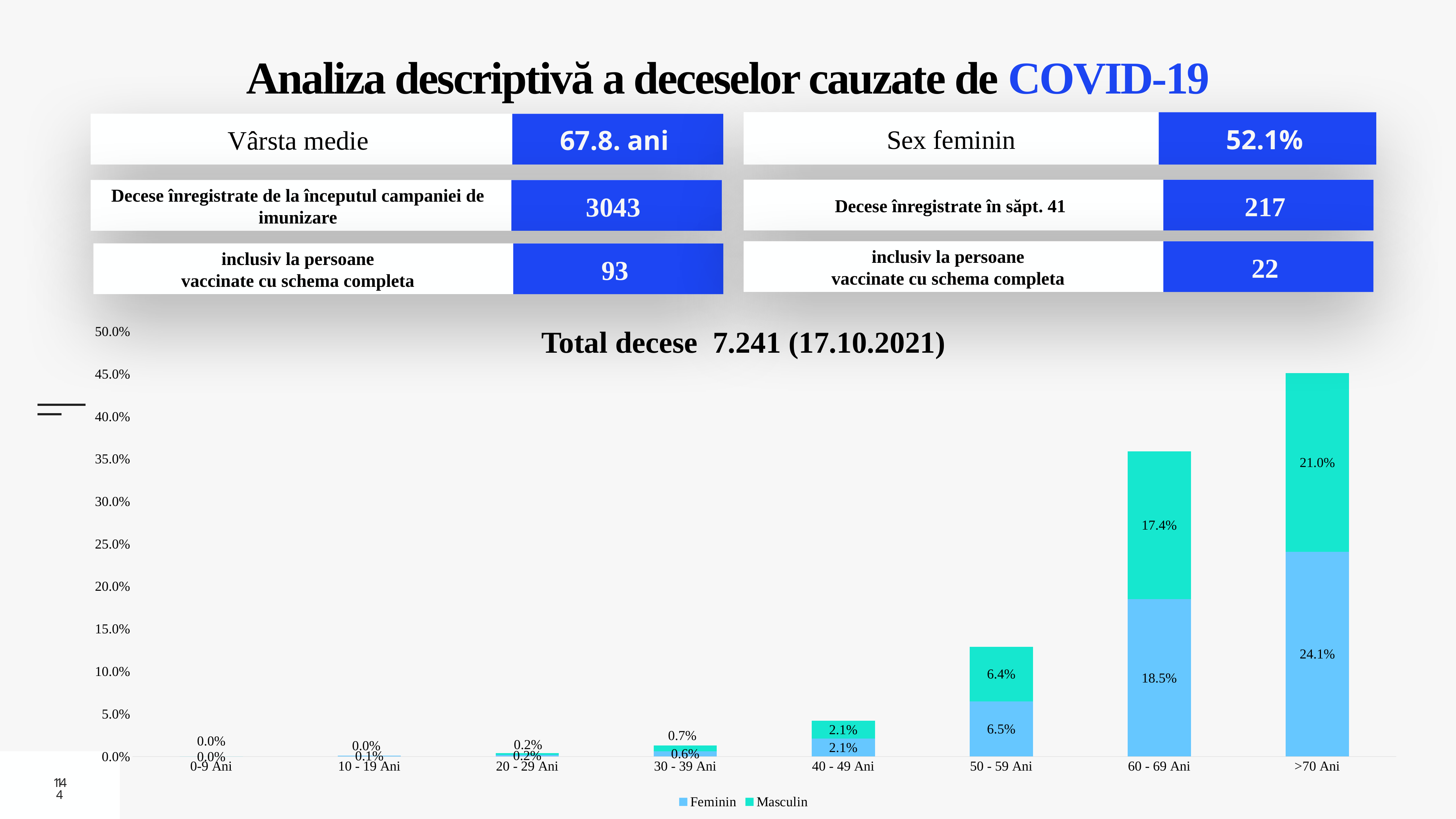
Which age group has the highest Masculin value? >70 Ani What is the Feminin value for the 50 - 59 Ani age group? 6.5% Is the total stacked bar for >70 Ani greater or less than 40.0%? greater Do the stacked bar totals rise or fall as the age groups increase along the x axis? Rise How many age groups are shown on the x axis? 8 What is the total of the stacked bar for the 60 - 69 Ani age group? 35.9% What is the difference between the Feminin and Masculin values for the >70 Ani age group? 3.1% What kind of chart is shown on the slide? Stacked bar chart Which is larger for the 60 - 69 Ani age group, the Feminin value or the Masculin value? Feminin How many series does the legend list? 2 What is the Masculin value for the 60 - 69 Ani age group? 17.4% What is the Feminin value for the >70 Ani age group? 24.1%